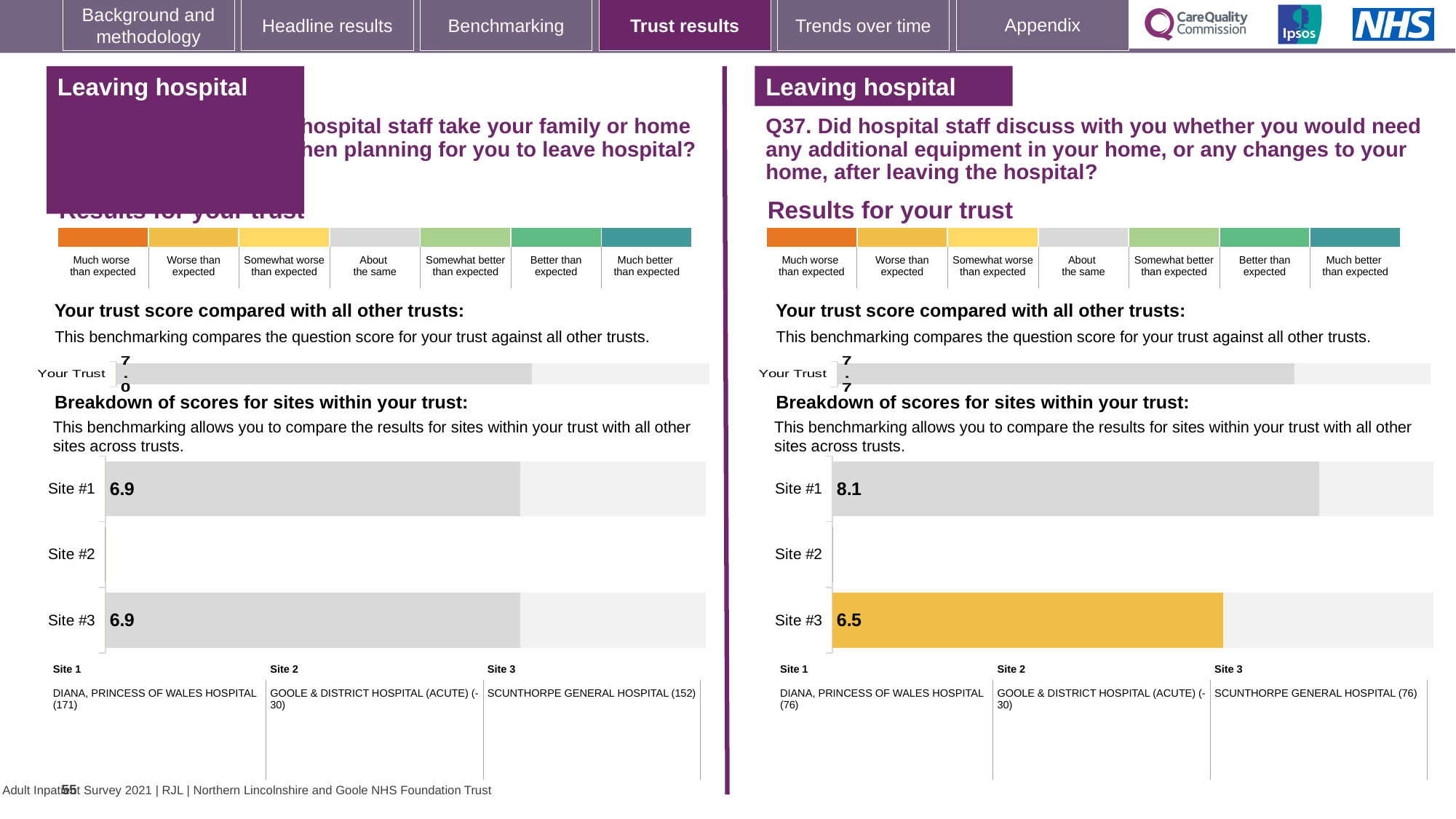
On the right-hand chart (Q37), what is the score for Site #1? 8.1 How many sites are listed in the site breakdown chart on the right-hand side (Q37)? 3 On the right-hand chart (Q37), what is the score for Site #3? 6.5 On the right-hand chart (Q37), which site's bar is coloured yellow rather than grey? Site #3 On the right-hand side (Q37), what is the 'Your Trust' score shown in the trust benchmarking bar? 7.7 What type of chart is used for the breakdown of scores for sites within your trust? Bar chart On the left-hand chart, what is the score for Site #1? 6.9 On the left-hand side, what is the 'Your Trust' score shown in the trust benchmarking bar? 7.0 On the right-hand chart (Q37), which site has the highest score? Site #1 On the right-hand chart (Q37), what is the difference between the Site #1 and Site #3 scores? 1.6 On the left-hand chart, what is the score for Site #3? 6.9 On the right-hand chart (Q37), which is larger, the score for Site #1 or Site #3? Site #1